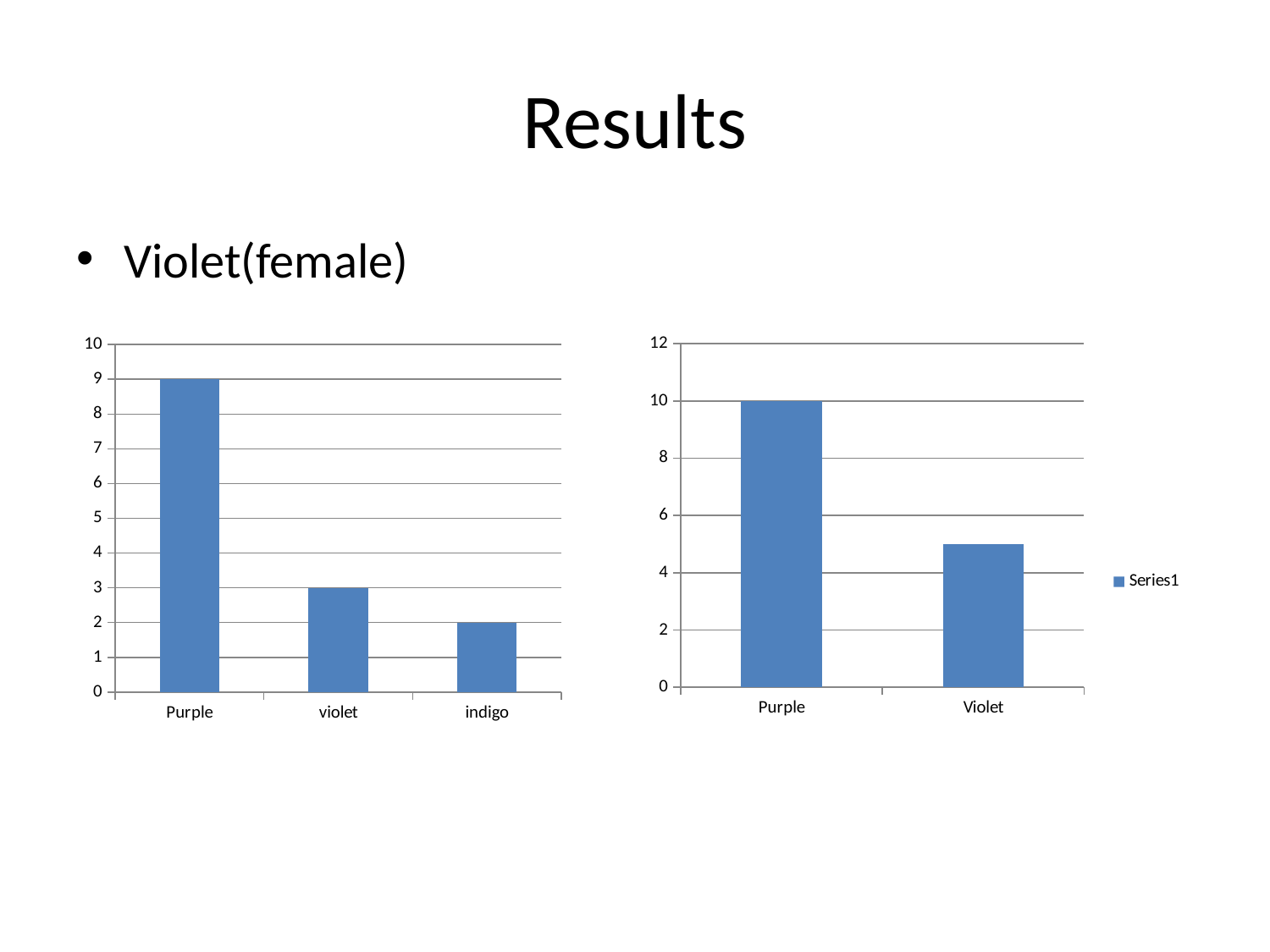
In the chart on the right, is the value for Violet greater or less than 4? greater In the chart on the left, how many categories are shown on the x axis? 3 In the chart on the right, which is larger, the value for Purple or the value for Violet? Purple In the chart on the left, which category has the lowest value? indigo In the chart on the right, what is the name of the series listed in the legend? Series1 In the chart on the left, what is the difference between the values for Purple and violet? 6 In the chart on the left, what is the value for violet? 3 In the chart on the left, what is the value for Purple? 9 In the chart on the right, what is the value for Purple? 10 In the chart on the left, which category has the highest value? Purple In the chart on the left, what is the value for indigo? 2 In the chart on the left, do the values rise or fall from left to right along the x axis? fall